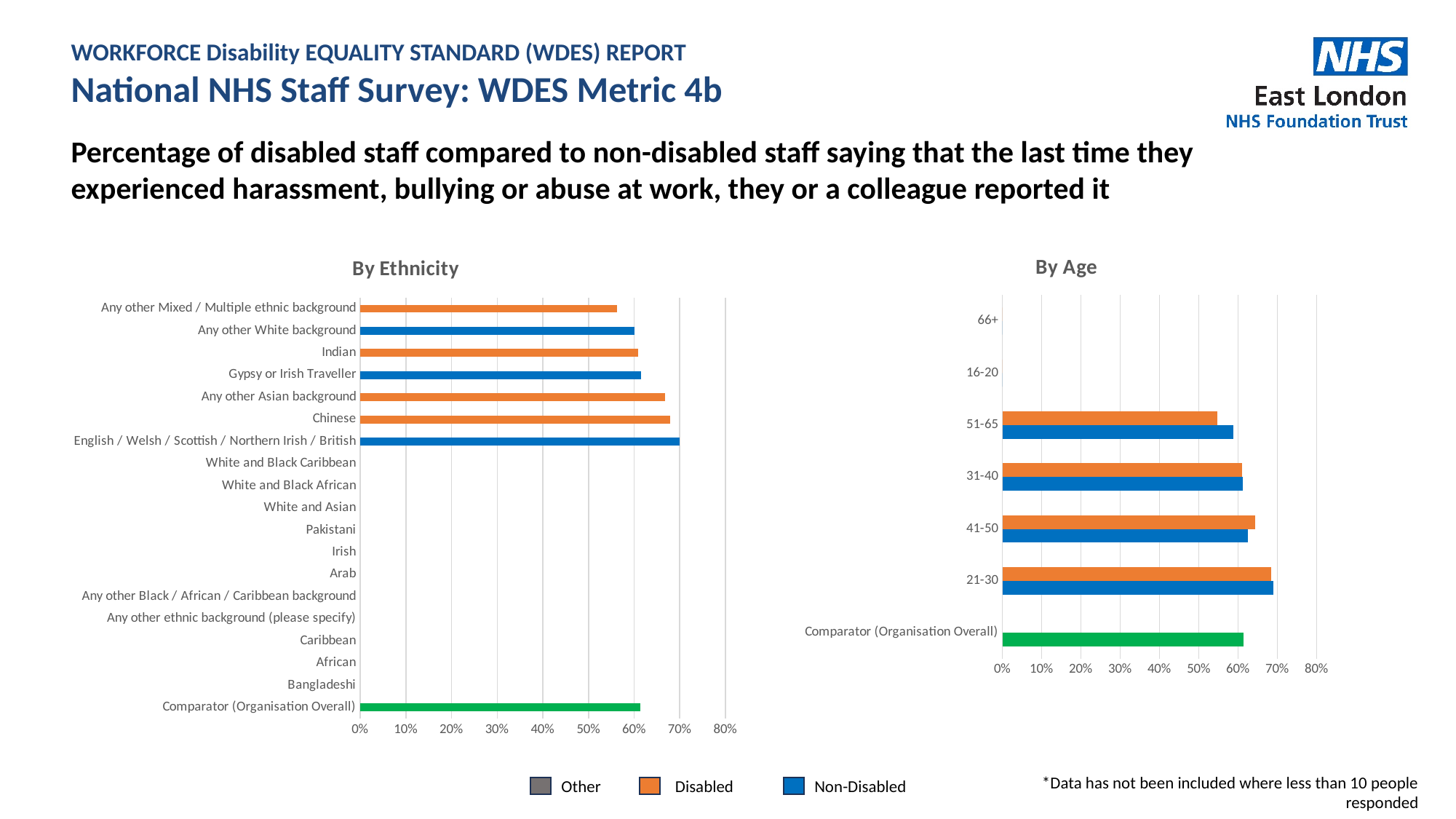
What colour represents the Disabled series in the legend? orange In the 'By Ethnicity' chart, is the value for Chinese greater or less than 60%? greater In the 'By Age' chart, which age group has the highest Disabled bar? 21-30 In the 'By Age' chart, for the 51-65 age group, which is larger: the Disabled bar or the Non-Disabled bar? Non-Disabled In the 'By Ethnicity' chart, which ethnic group has the lowest plotted bar? Any other Mixed / Multiple ethnic background In the 'By Ethnicity' chart, is the value for English / Welsh / Scottish / Northern Irish / British greater or less than 60%? greater How many series does the legend at the bottom of the slide list? 3 In the 'By Age' chart, is the Disabled value for 51-65 greater or less than 60%? less What kind of chart is the 'By Ethnicity' chart? bar chart In the 'By Age' chart, which age group has the lowest Disabled bar? 51-65